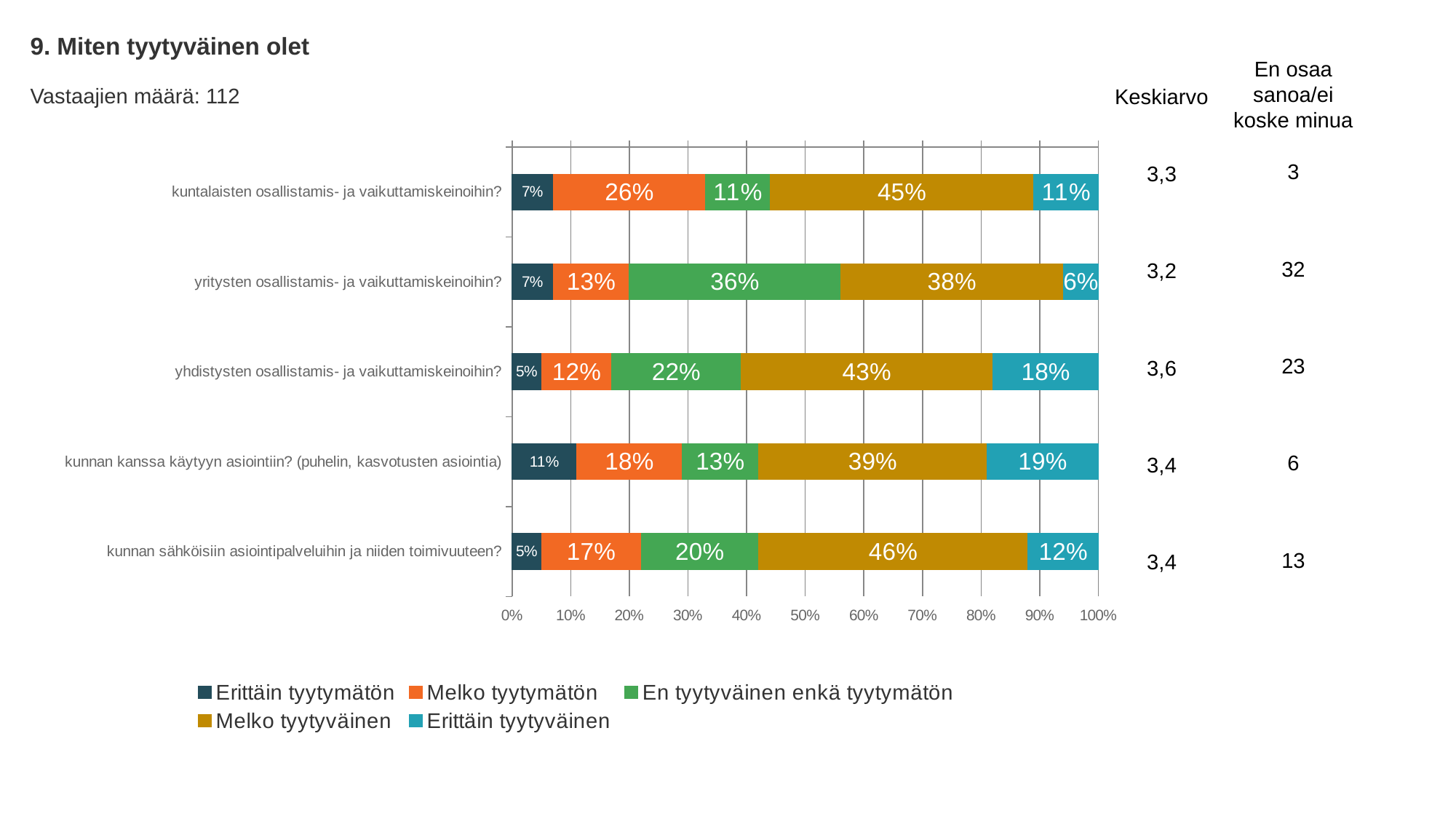
Which category has the highest "Melko tyytyväinen" share? kunnan sähköisiin asiointipalveluihin ja niiden toimivuuteen? How many series does the legend list? 5 Which category has the lowest "Erittäin tyytyväinen" share? yritysten osallistamis- ja vaikuttamiskeinoihin? What is the Keskiarvo value shown for "yhdistysten osallistamis- ja vaikuttamiskeinoihin?"? 3,6 What is the "En tyytyväinen enkä tyytymätön" share for "yritysten osallistamis- ja vaikuttamiskeinoihin?" 36% What percentage of respondents were "Melko tyytymätön" with "kuntalaisten osallistamis- ja vaikuttamiskeinoihin?" 26% What is the total of the stacked bar for "kuntalaisten osallistamis- ja vaikuttamiskeinoihin?"? 100% How many categories (bars) does the chart show? 5 What is the difference between the "Melko tyytyväinen" shares for "yhdistysten osallistamis- ja vaikuttamiskeinoihin?" and "kunnan kanssa käytyyn asiointiin? (puhelin, kasvotusten asiointia)"? 4% What is the "Erittäin tyytyväinen" share for "kunnan kanssa käytyyn asiointiin? (puhelin, kasvotusten asiointia)"? 19% What kind of chart is shown on the slide? Stacked bar chart Which is larger: the "Erittäin tyytymätön" share for "kunnan kanssa käytyyn asiointiin? (puhelin, kasvotusten asiointia)" or for "yhdistysten osallistamis- ja vaikuttamiskeinoihin?"? kunnan kanssa käytyyn asiointiin? (puhelin, kasvotusten asiointia)